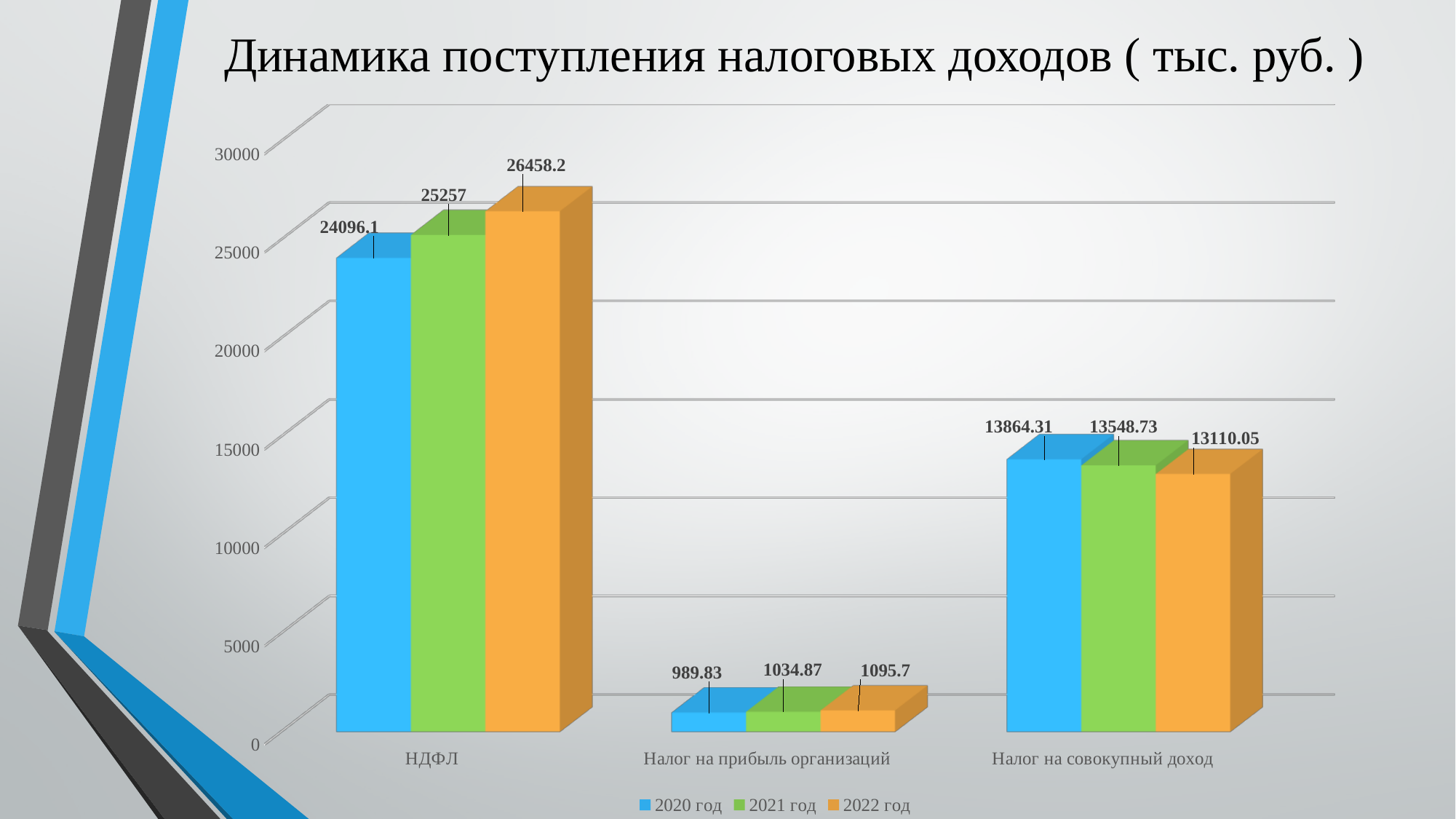
What is the value for Налог на совокупный доход in 2021 год? 13548.73 Which category has the highest value in 2021 год? НДФЛ How many series does the legend list? 3 What is the difference between the 2022 год and 2020 год values for НДФЛ? 2362.1 Is the 2021 год value for НДФЛ greater or less than 25000? greater What is the value for Налог на прибыль организаций in 2020 год? 989.83 Which category has the lowest value in 2022 год? Налог на прибыль организаций How many categories are shown on the x axis? 3 Do the values for НДФЛ rise or fall from 2020 год to 2022 год? rise Which is larger for Налог на совокупный доход: the 2020 год value or the 2022 год value? 2020 год What is the difference between the 2020 год and 2022 год values for Налог на совокупный доход? 754.26 What is the value for НДФЛ in 2022 год? 26458.2